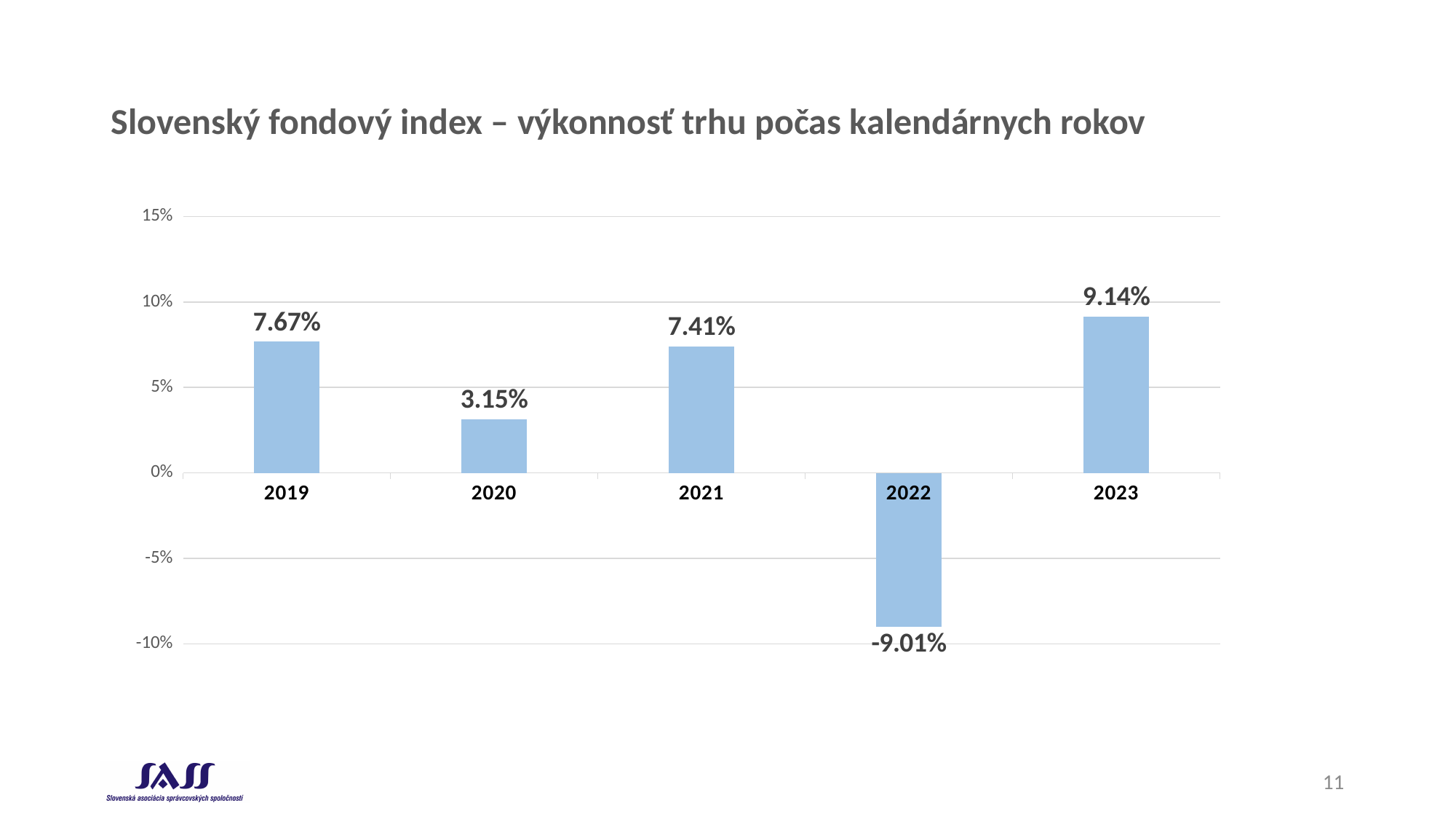
Which is larger, the value for 2019 or the value for 2020? 2019 What is the value for 2023? 9.14% What is the value for 2019? 7.67% Is the value for 2021 greater or less than 5%? greater What is the difference between the values for 2023 and 2021? 1.73% Which year has the lowest value? 2022 How many years are shown on the x axis? 5 What is the title of the chart? Slovenský fondový index – výkonnosť trhu počas kalendárnych rokov What kind of chart is shown on the slide? bar chart Which year has the highest value? 2023 What is the value for 2020? 3.15% What is the value for 2022? -9.01%